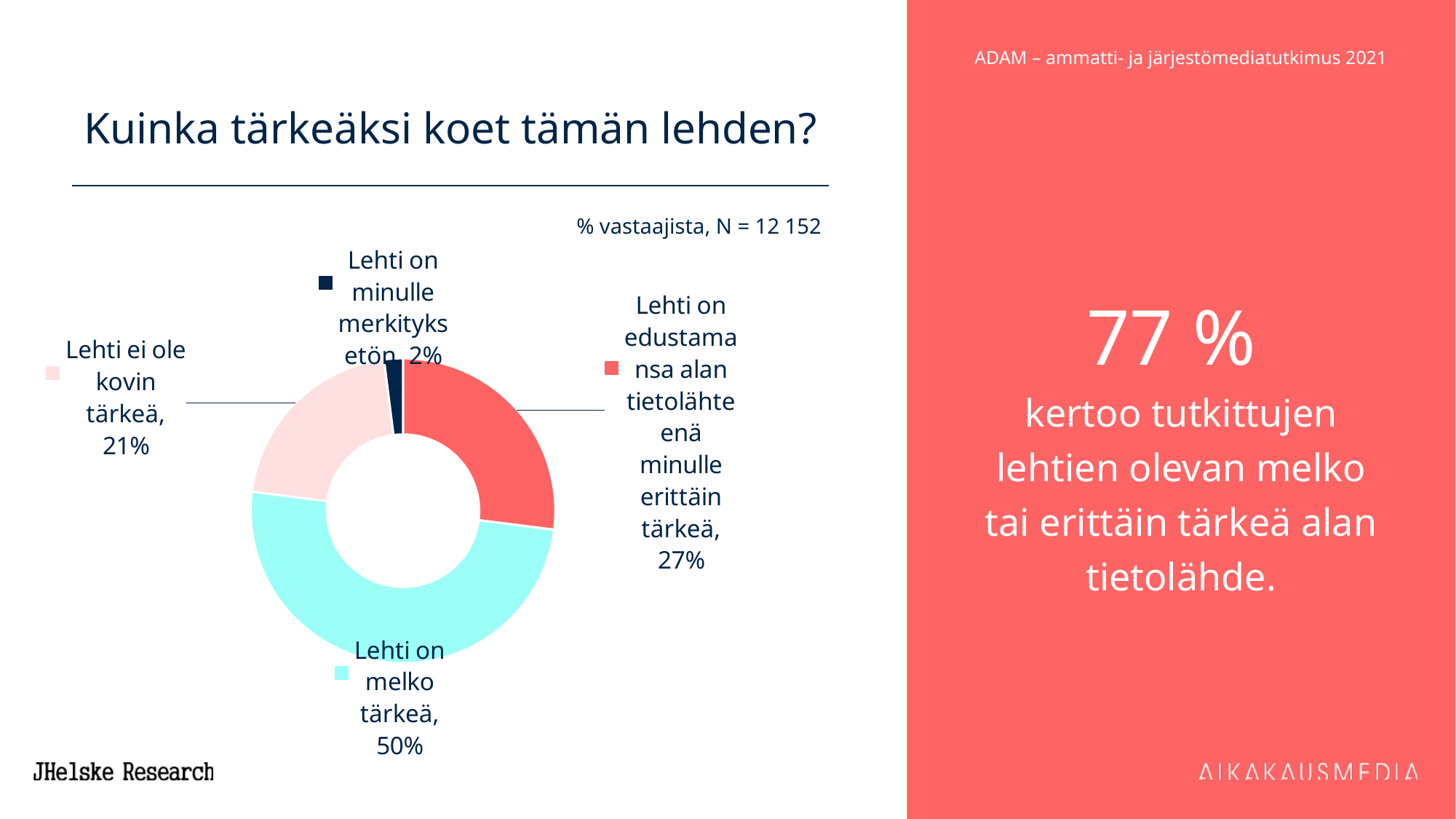
Which is larger: the share for "erittäin tärkeä" or the share for "Lehti ei ole kovin tärkeä"? erittäin tärkeä (27%) What percentage of respondents say "Lehti on melko tärkeä"? 50% What percentage of respondents say the magazine is "erittäin tärkeä" as an information source for its field? 27% What percentage of respondents say "Lehti on minulle merkityksetön"? 2% What is the number of respondents (N) stated on the chart? 12 152 What is the combined share of "melko tärkeä" and "erittäin tärkeä"? 77% Which category has the smallest share of the chart? Lehti on minulle merkityksetön What kind of chart is shown on the slide? Pie chart (donut) How many categories does the chart show? 4 What percentage of respondents say "Lehti ei ole kovin tärkeä"? 21% What is the difference in percentage points between "Lehti on melko tärkeä" and "Lehti ei ole kovin tärkeä"? 29 percentage points Which category has the largest share of the chart? Lehti on melko tärkeä